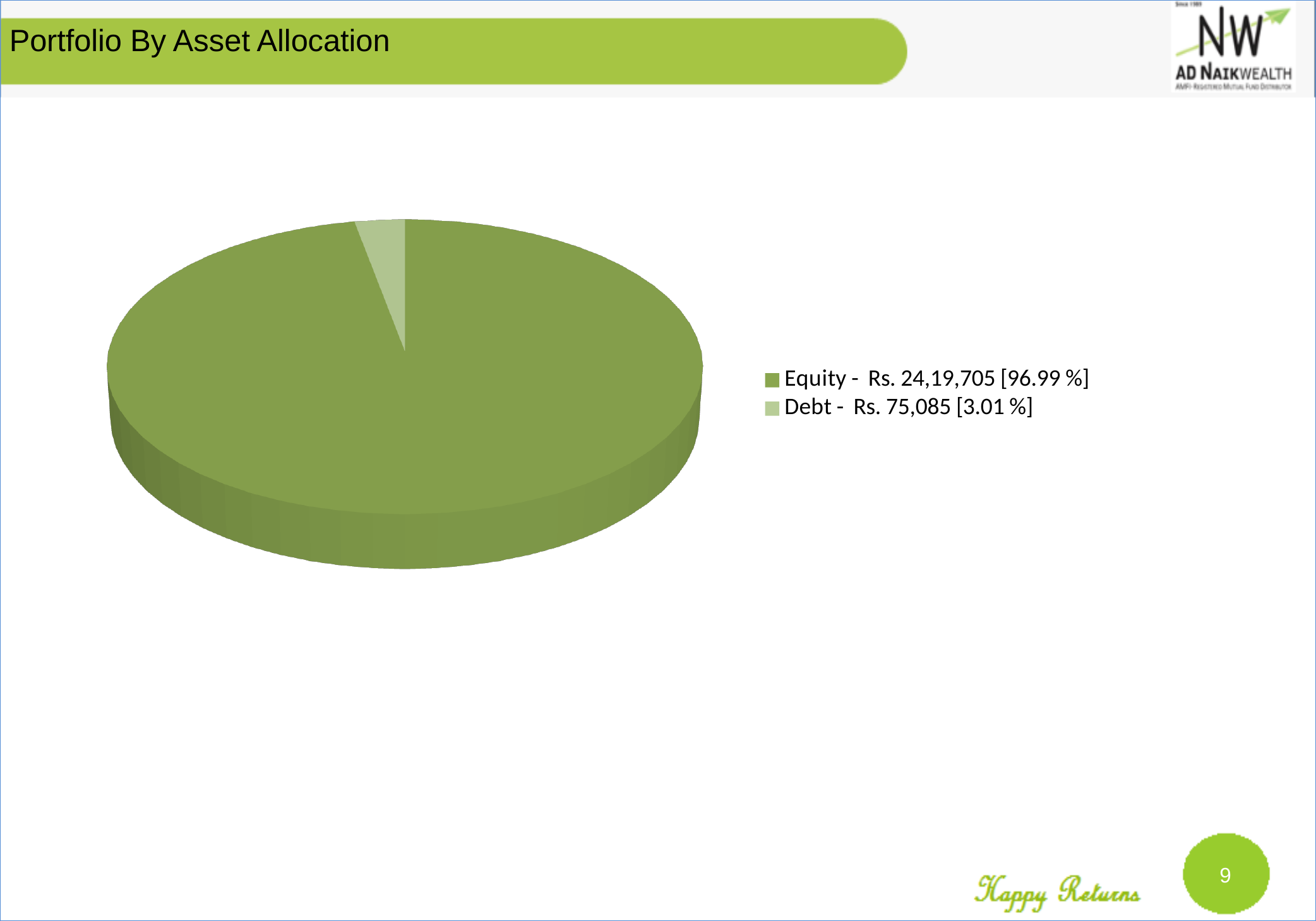
What kind of chart is shown on the slide? Pie chart Which category has the smallest slice of the pie? Debt What is the title of the slide containing the pie chart? Portfolio By Asset Allocation Which category has the largest slice of the pie? Equity How many slices does the pie chart have? 2 Which is larger, the Equity slice or the Debt slice? Equity What share of the pie does Debt represent? 3.01 % What is the value for Debt in the pie chart? Rs. 75,085 What share of the pie does Equity represent? 96.99 % What is the difference in percentage share between Equity and Debt? 93.98 % How many entries does the legend of the pie chart list? 2 What is the value for Equity in the pie chart? Rs. 24,19,705